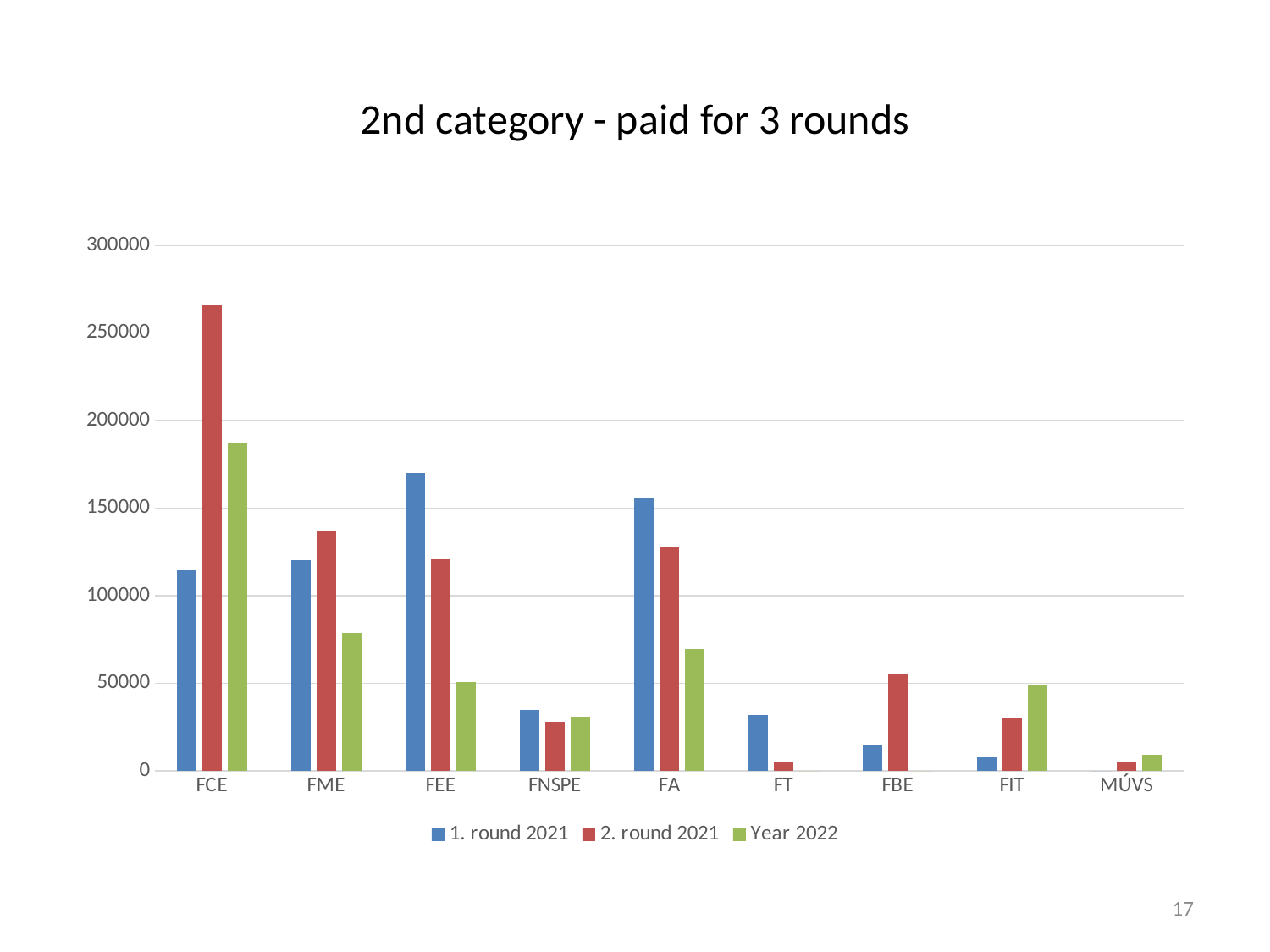
For FEE, which is larger: the 1. round 2021 value or the 2. round 2021 value? 1. round 2021 Is the 1. round 2021 value for FEE greater or less than 150000? greater Which category has the highest value for 2. round 2021? FCE What kind of chart is shown on the slide? Bar chart Which colour represents the Year 2022 series in the legend? Green Is the Year 2022 value for FA greater or less than 100000? less How many categories are shown on the x axis? 9 Which category has the highest value for 1. round 2021? FEE Is the 2. round 2021 value for FCE greater or less than 250000? greater What is the title of the chart? 2nd category - paid for 3 rounds How many series does the legend list? 3 For FME, which is larger: the 1. round 2021 value or the 2. round 2021 value? 2. round 2021